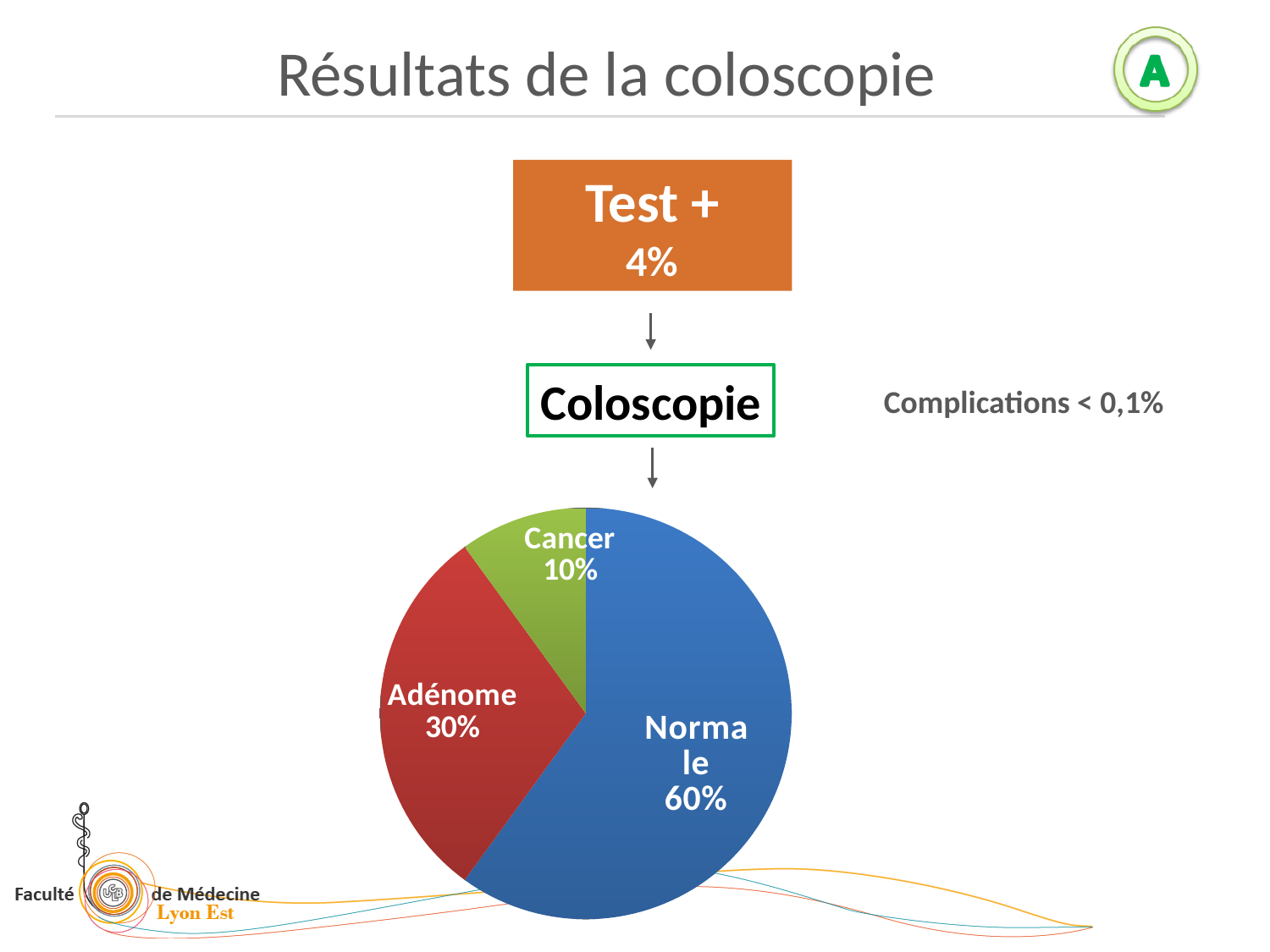
What is the difference between the Adénome and Cancer shares in the pie chart? 20% What percentage of the pie chart is labelled Cancer? 10% What colour is the Cancer slice of the pie chart? green What percentage of the pie chart is labelled Adénome? 30% What colour is the Adénome slice of the pie chart? red Which slice of the pie chart is the largest? Normale What kind of chart is shown on the slide? pie chart Which slice of the pie chart is the smallest? Cancer How many slices does the pie chart have? 3 What is the difference between the Normale and Adénome shares in the pie chart? 30% Which is larger in the pie chart, Adénome or Cancer? Adénome What percentage of the pie chart is labelled Normale? 60%